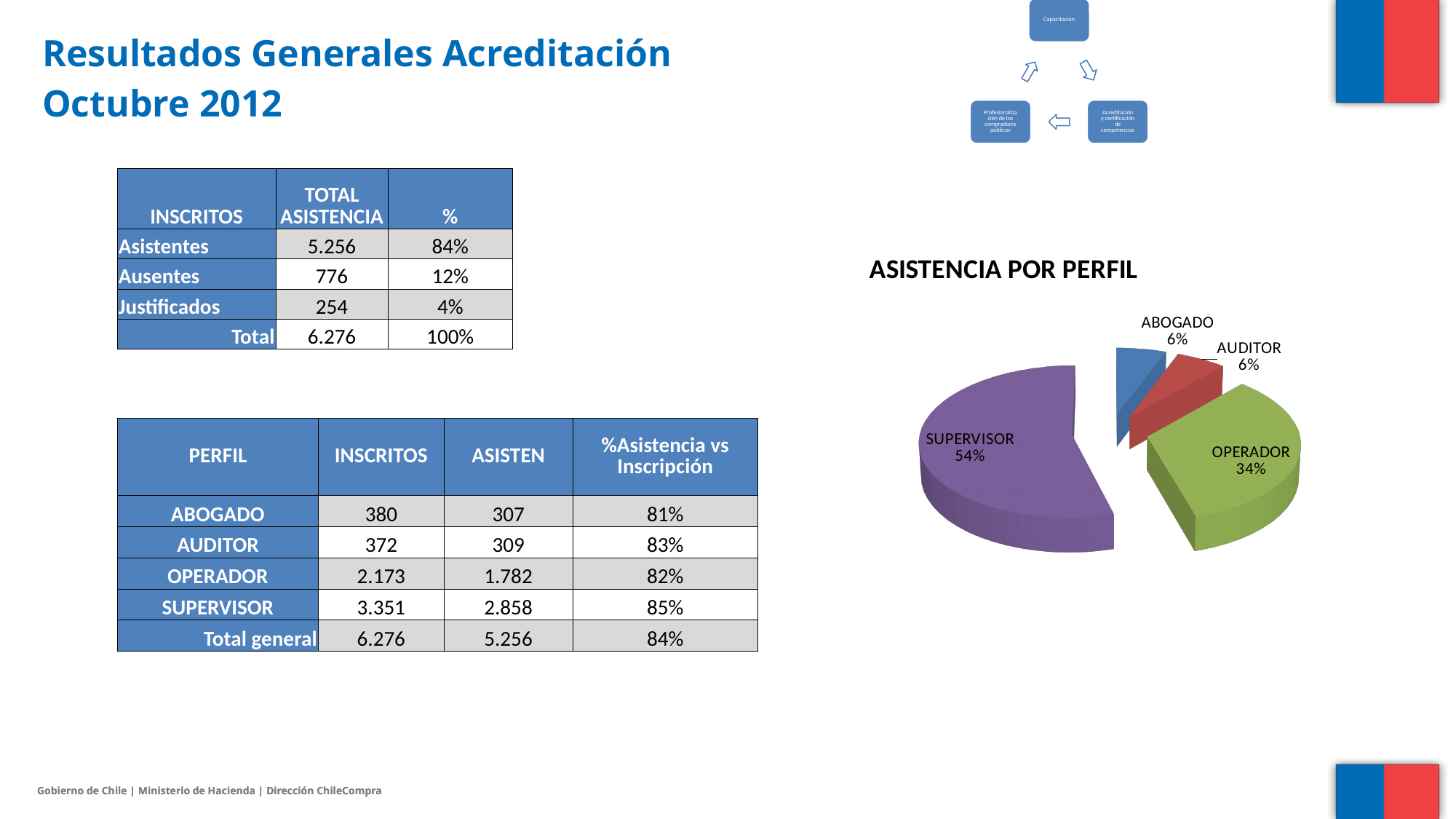
What kind of chart is shown on the slide? Pie chart What is the difference in percentage points between SUPERVISOR and OPERADOR in the pie chart? 20 Which is larger in the pie chart, OPERADOR or ABOGADO? OPERADOR How many slices does the pie chart have? 4 What is the value shown for AUDITOR in the pie chart? 6% What colour is the SUPERVISOR slice in the pie chart? Purple What share of the pie does SUPERVISOR represent? 54% Which category has the largest slice in the pie chart? SUPERVISOR What is the title of the chart on the slide? ASISTENCIA POR PERFIL What is the value shown for ABOGADO in the pie chart? 6% What is the combined share of ABOGADO and AUDITOR in the pie chart? 12% What is the value shown for OPERADOR in the pie chart? 34%